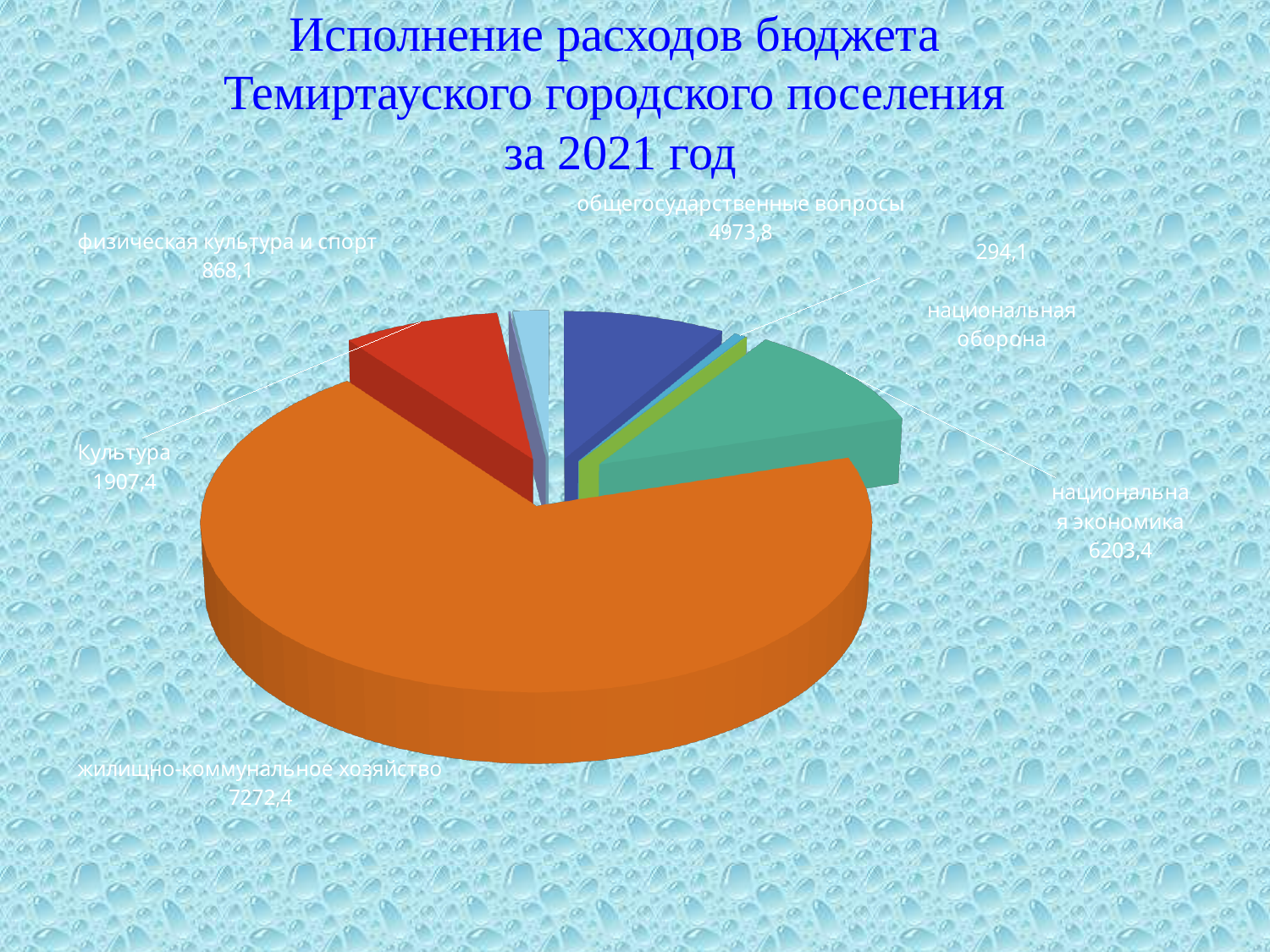
What year does the chart title say the budget expenditure data is for? 2021 What value is shown for национальная оборона? 294,1 What value is shown for Культура? 1907,4 Which category has the largest slice of the pie? жилищно-коммунальное хозяйство What kind of chart is shown on the slide? Pie chart What value is shown for общегосударственные вопросы? 4973,8 Which labelled category has the smallest value? национальная оборона What is the difference between the values for жилищно-коммунальное хозяйство and национальная экономика? 1069,0 Which is larger, the value for Культура or the value for физическая культура и спорт? Культура What value is shown for национальная экономика? 6203,4 What value is shown for жилищно-коммунальное хозяйство? 7272,4 What value is shown for физическая культура и спорт? 868,1